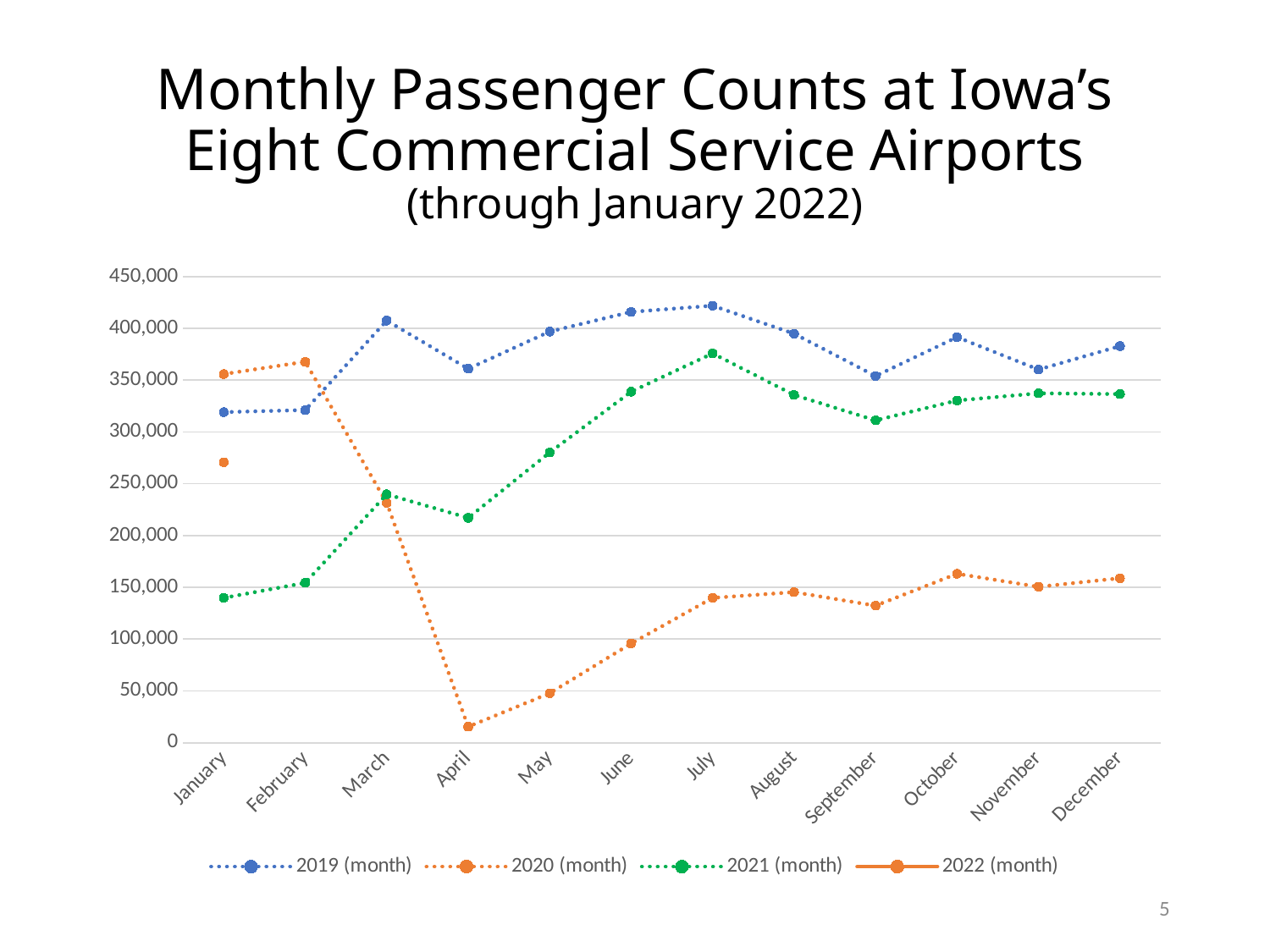
Which series has the higher value in July: 2019 (month) or 2021 (month)? 2019 (month) What kind of chart is shown on the slide? line chart Is the value for July in the 2019 (month) series greater or less than 400,000? greater Which series in the legend has only a single plotted point? 2022 (month) Is the value for January in the 2022 (month) series greater or less than 250,000? greater Does the 2021 (month) series rise or fall from January to July? rise In which month does the 2021 (month) series reach its highest value? July Which series has the higher value in January: 2019 (month) or 2020 (month)? 2020 (month) How many series does the legend list? 4 Is the value for April in the 2020 (month) series greater or less than 50,000? less How many months are shown along the x axis? 12 In which month does the 2020 (month) series reach its lowest value? April